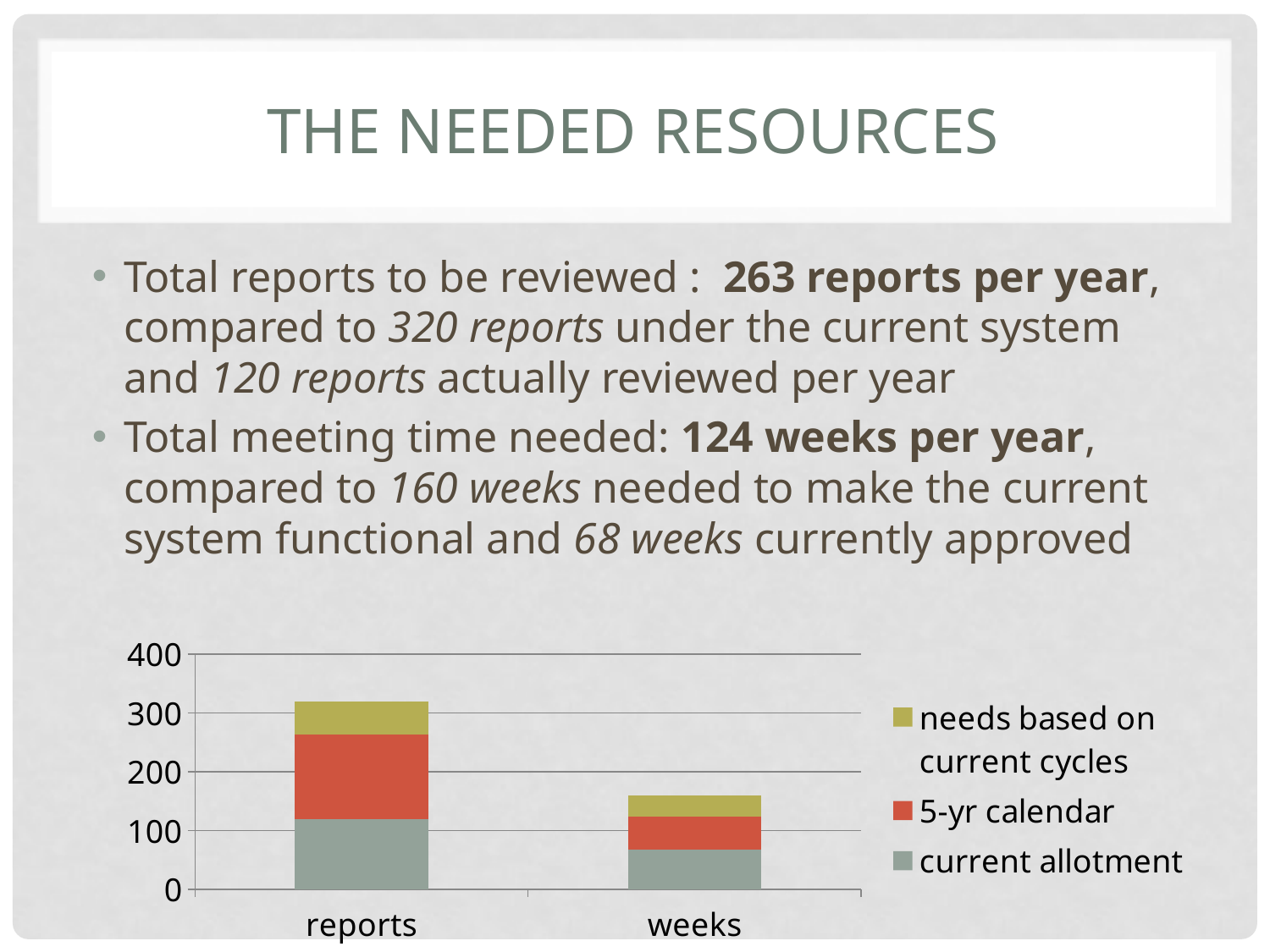
Which category has the lowest stacked bar total? weeks How many series does the chart legend list? 3 What is the highest value shown on the chart's vertical axis? 400 What colour represents the 5-yr calendar series in the chart? red Is the total of the stacked bar for weeks greater or less than 200? less What kind of chart is shown on the slide? stacked bar chart Is the current allotment segment for weeks greater or less than 100? less Is the total of the stacked bar for reports greater or less than 300? greater Which category has the taller stacked bar, reports or weeks? reports Which series is shown at the bottom of each stacked bar? current allotment How many categories are shown on the x axis of the chart? 2